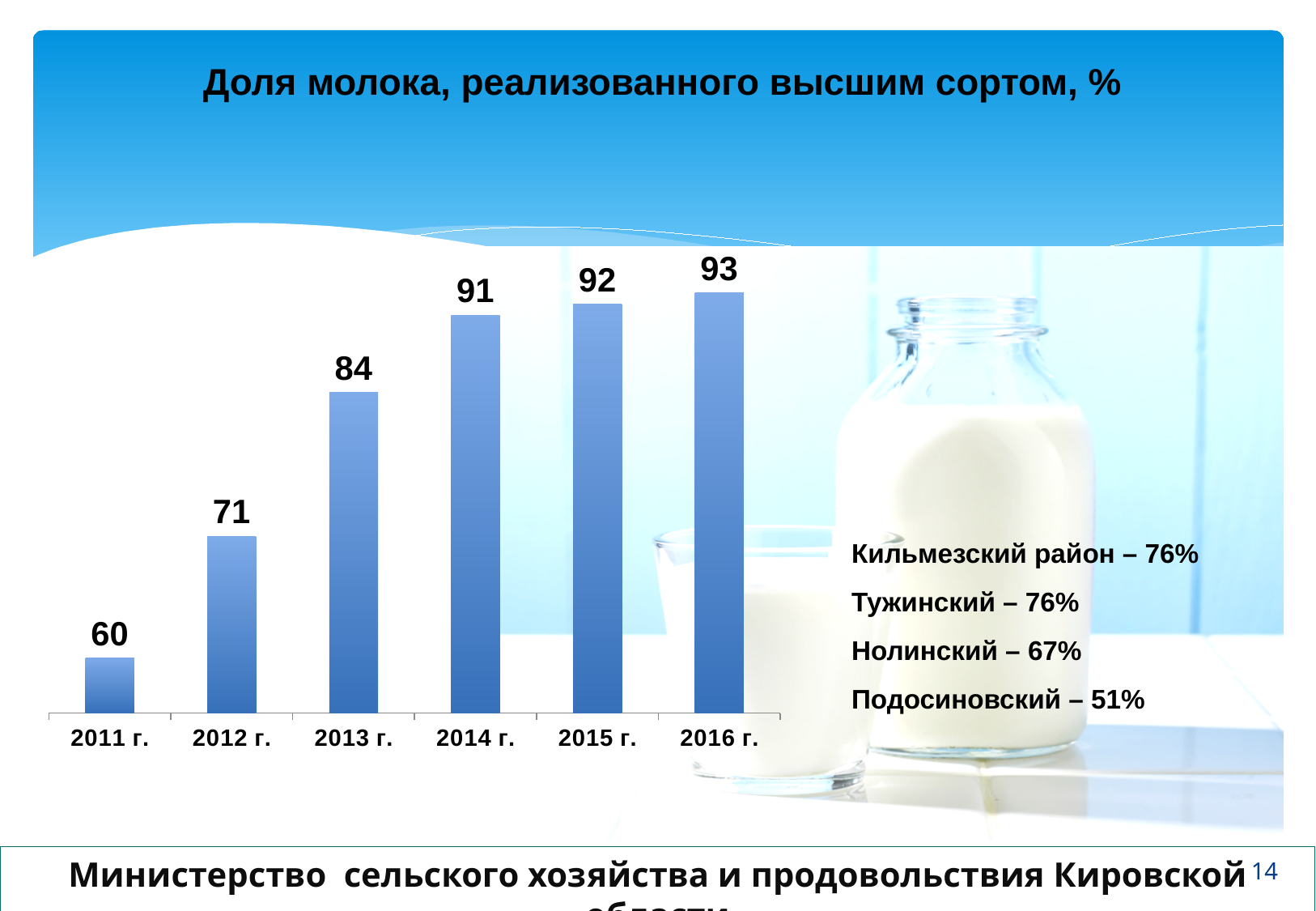
What is the value for 2016 г.? 93 What is the value for 2011 г.? 60 How many years are shown on the chart? 6 What is the difference between the values for 2016 г. and 2011 г.? 33 Do the values rise or fall from 2011 г. to 2016 г.? rise What is the value for 2014 г.? 91 What is the title of the chart? Доля молока, реализованного высшим сортом, % Which is larger, the value for 2012 г. or the value for 2013 г.? 2013 г. What is the difference between the values for 2013 г. and 2012 г.? 13 Which year has the lowest value? 2011 г. What kind of chart is shown on the slide? bar chart Which year has the highest value? 2016 г.